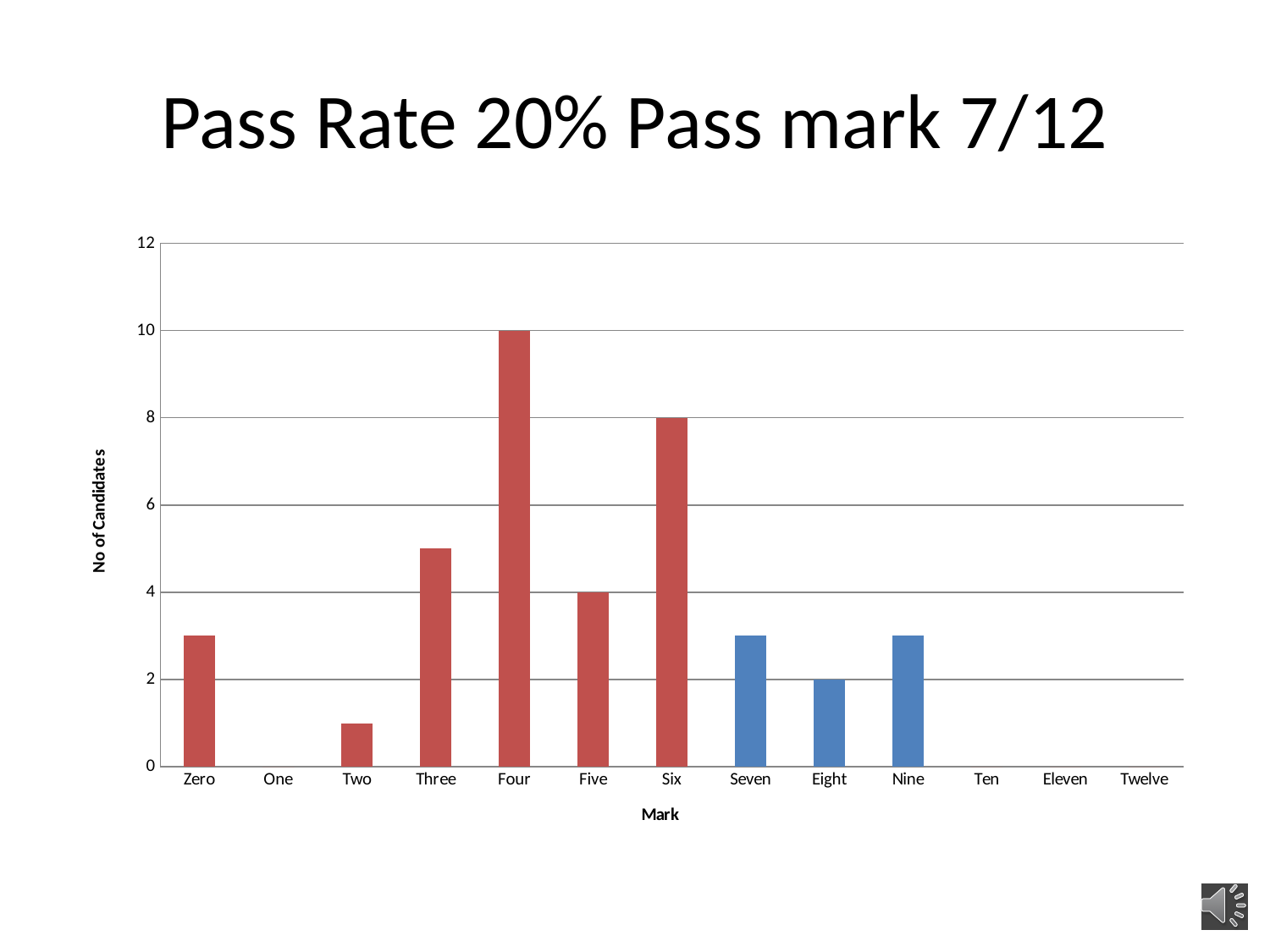
Which mark has the highest number of candidates? Four How many candidates scored a mark of Six? 8 How many candidates scored a mark of Eight? 2 What is the title of the vertical axis? No of Candidates Is the number of candidates with a mark of Two greater or less than 2? less How many mark categories are shown on the x axis? 13 How many candidates scored a mark of Five? 4 What kind of chart is shown on the slide? bar chart What is the difference between the number of candidates with a mark of Four and those with a mark of Six? 2 Which has more candidates, a mark of Six or a mark of Five? Six Is the number of candidates with a mark of Three greater or less than 4? greater How many candidates scored a mark of Four? 10